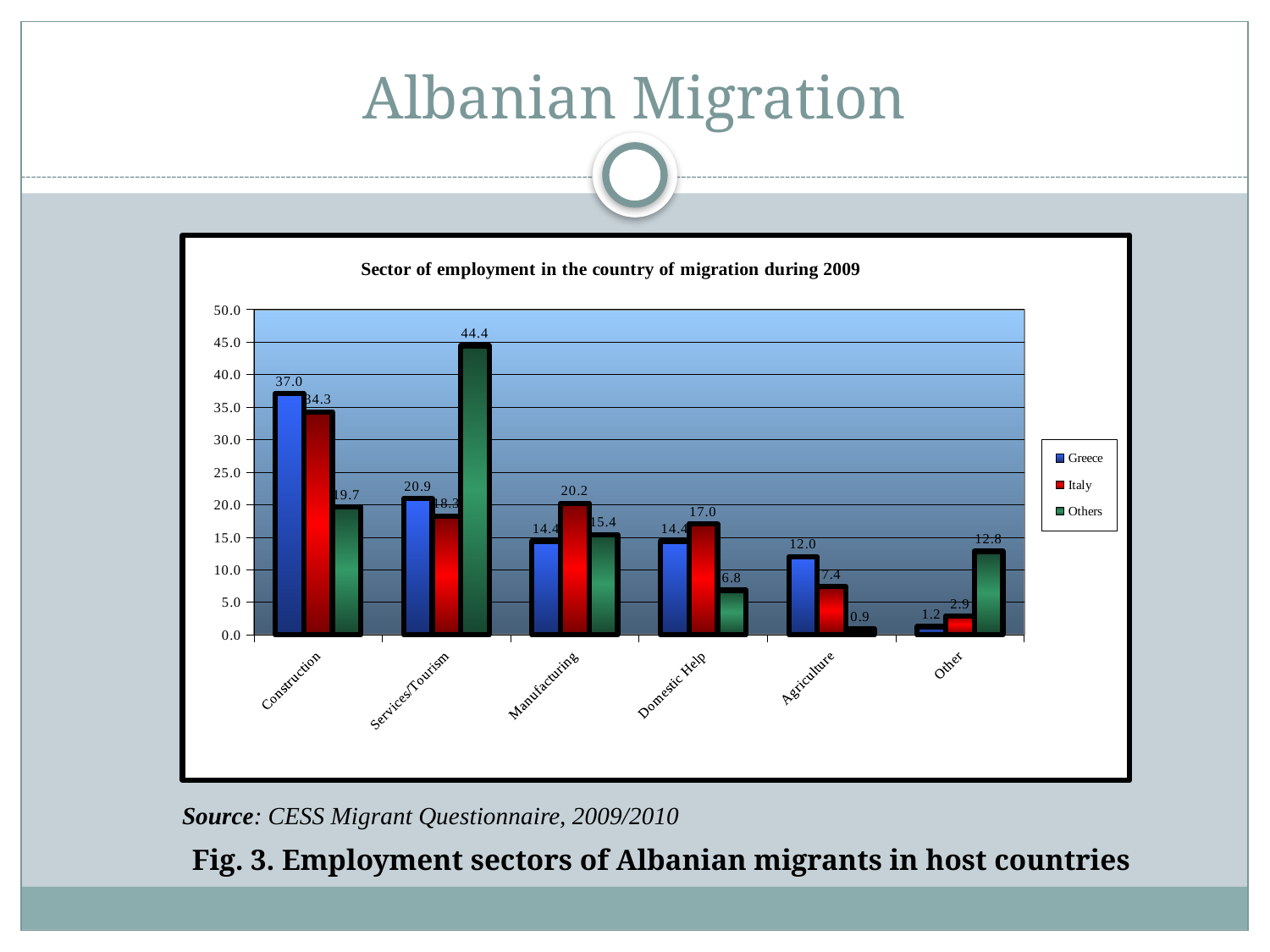
What is the value for Italy in the Manufacturing sector? 20.2 Is the value for Others in the Other sector greater or less than 10.0? greater What is the difference between the Italy and Others values for Domestic Help? 10.2 What kind of chart is shown on the slide? bar chart What is the value for Others in the Services/Tourism sector? 44.4 In which sector does the Greece series have its lowest value? Other How many employment sectors are shown on the x axis? 6 In which sector does the Others series have its highest value? Services/Tourism What is the value for Others in the Agriculture sector? 0.9 What is the value for Greece in the Construction sector? 37.0 In the Agriculture sector, which is larger: the value for Greece or for Italy? Greece How many series does the legend list? 3